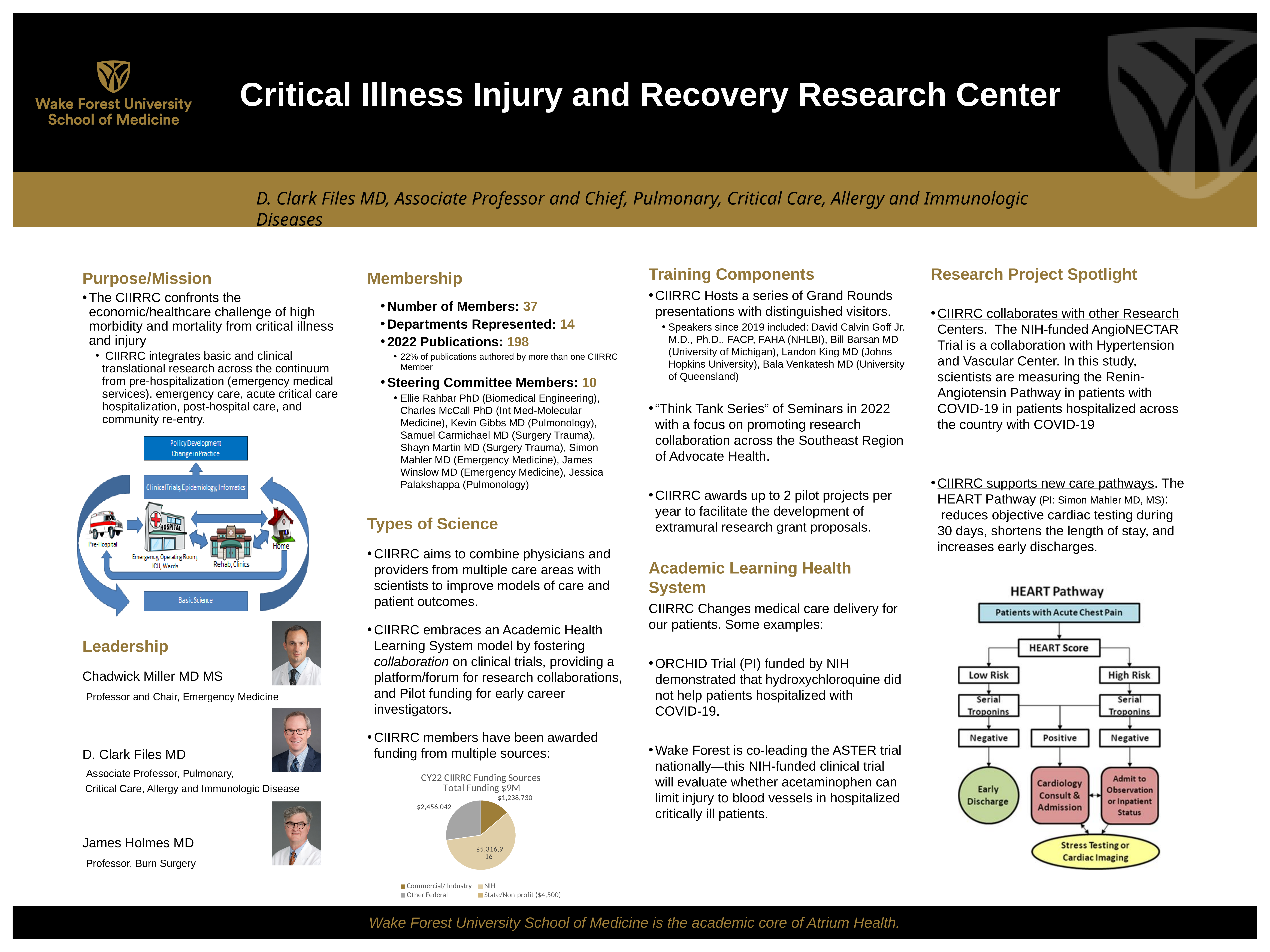
How many funding sources does the legend of the pie chart list? 4 Which funding source is the smallest in the pie chart? State/Non-profit In the pie chart, which is larger: Other Federal or Commercial/Industry funding? Other Federal What is the title of the pie chart? CY22 CIIRRC Funding Sources Total Funding $9M In the pie chart, what is the funding amount from NIH? $5,316,916 In the pie chart, how much larger is NIH funding than Other Federal funding? $2,860,874 What kind of chart is the CY22 CIIRRC Funding Sources chart? pie chart Which funding source is the largest in the pie chart? NIH In the pie chart, what is the funding amount from State/Non-profit? $4,500 In the pie chart, what is the funding amount from Commercial/Industry? $1,238,730 In the pie chart, what is the funding amount from Other Federal sources? $2,456,042 According to the pie chart title, what is the total CY22 funding? $9M